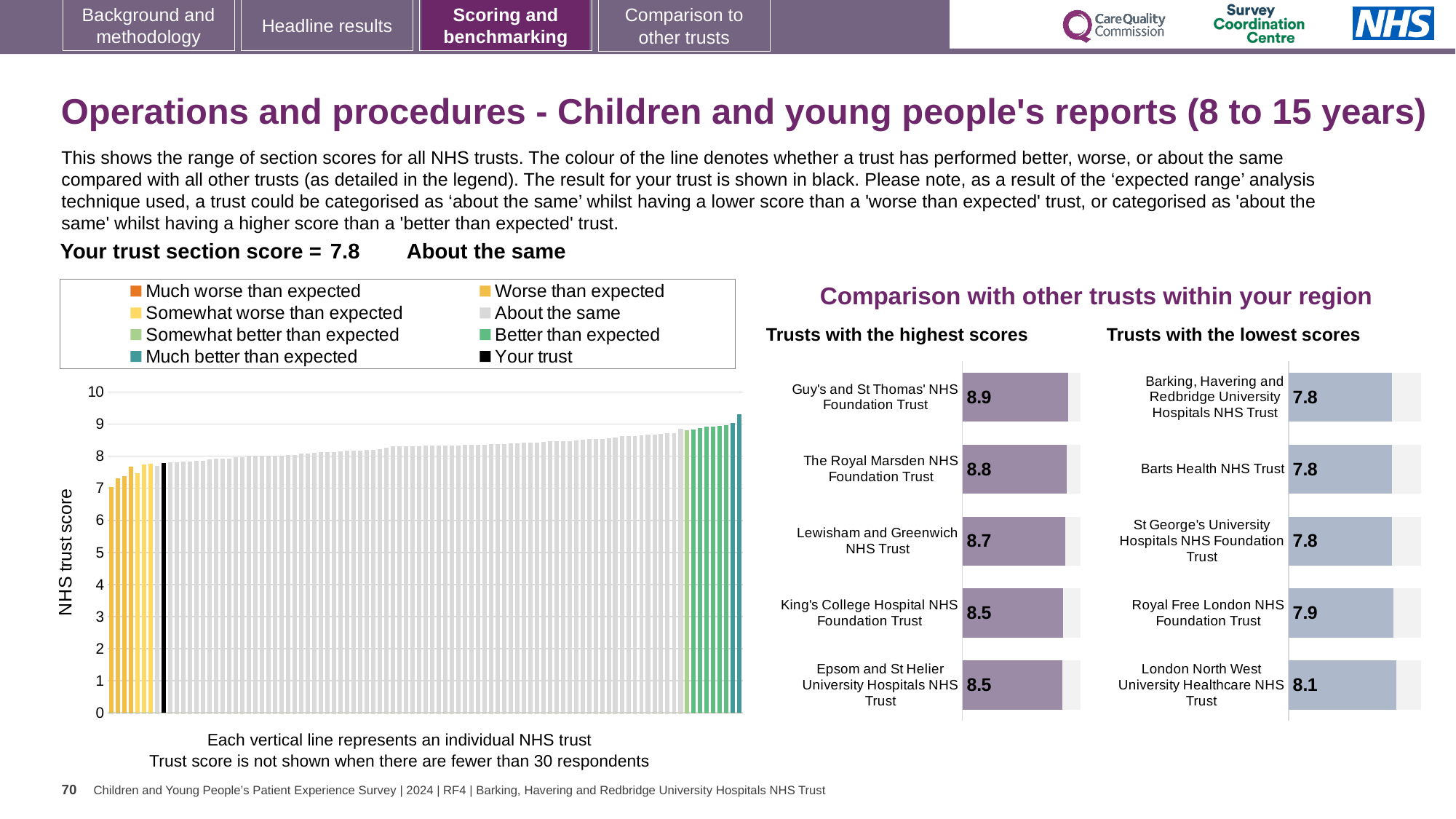
In the 'Trusts with the highest scores' chart, how many trusts are shown? 5 In the 'Trusts with the highest scores' chart, which trust has the highest score? Guy's and St Thomas' NHS Foundation Trust In the 'Trusts with the lowest scores' chart, what is the score for Barts Health NHS Trust? 7.8 In the 'Trusts with the highest scores' chart, what is the difference between the scores of Guy's and St Thomas' NHS Foundation Trust and King's College Hospital NHS Foundation Trust? 0.4 In the 'Trusts with the highest scores' chart, what is the score for Lewisham and Greenwich NHS Trust? 8.7 In the 'Trusts with the lowest scores' chart, what is the score for London North West University Healthcare NHS Trust? 8.1 In the 'Trusts with the lowest scores' chart, which is larger: the score for Royal Free London NHS Foundation Trust or the score for St George's University Hospitals NHS Foundation Trust? Royal Free London NHS Foundation Trust In the 'Trusts with the lowest scores' chart, which trust has the highest score? London North West University Healthcare NHS Trust In the NHS trust score chart on the left, do the bar values rise or fall from left to right? rise In the NHS trust score chart on the left, is the value of the tallest (rightmost) bar greater or less than 9? greater In the 'Trusts with the highest scores' chart, what is the score for Guy's and St Thomas' NHS Foundation Trust? 8.9 In the 'Trusts with the lowest scores' chart, what is the difference between the scores of London North West University Healthcare NHS Trust and Barking, Havering and Redbridge University Hospitals NHS Trust? 0.3